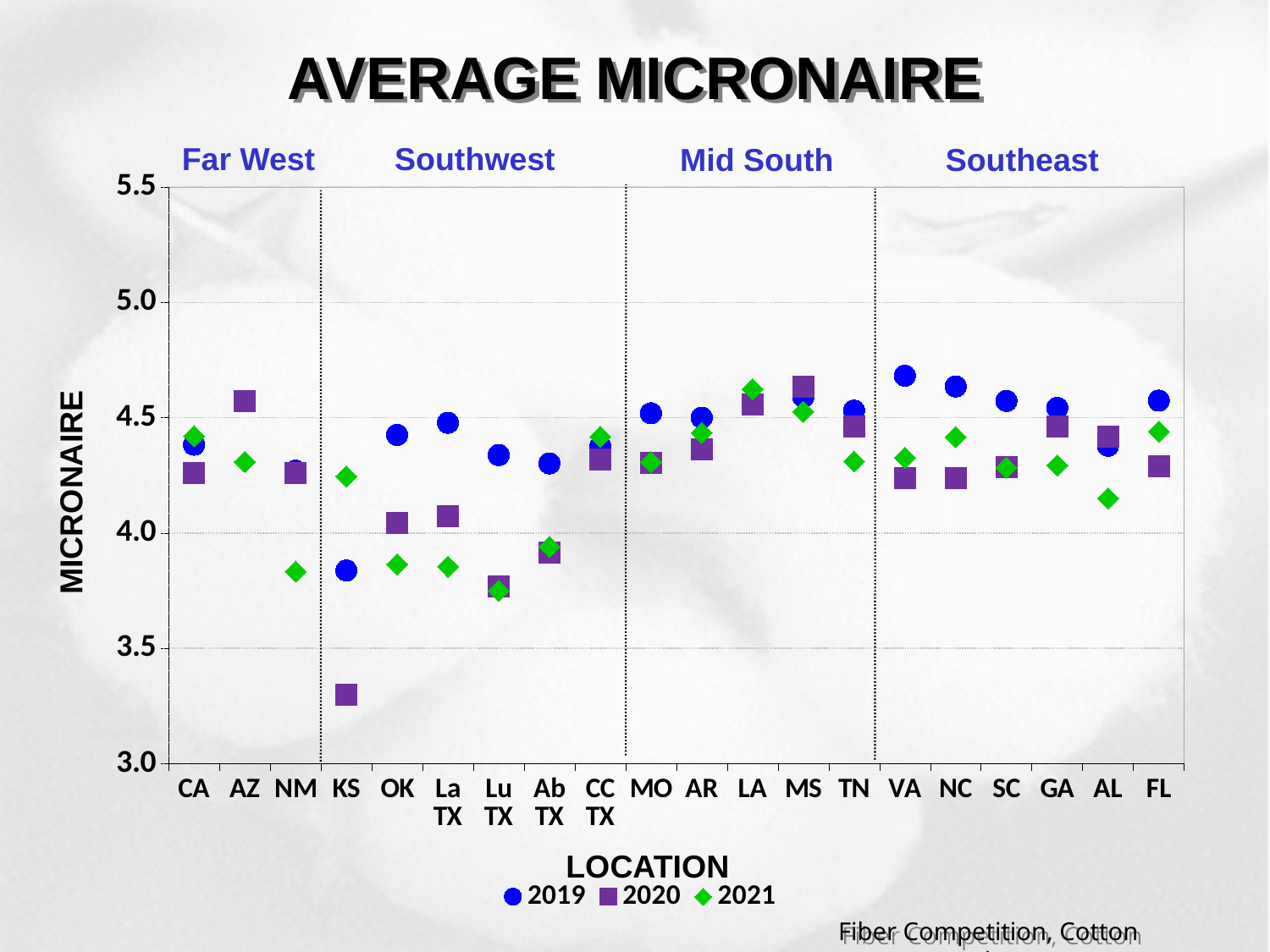
What is the title of the y axis? MICRONAIRE What kind of chart is shown on the slide? Scatter (dot) chart How many series does the legend list? 3 Is the 2019 value for VA greater or less than 4.5? greater Which location has the lowest 2019 micronaire value? KS Is the 2021 value for AL greater or less than 4.5? less Is the 2020 value for KS greater or less than 3.5? less For KS, which is larger, the 2019 value or the 2020 value? 2019 How many locations are plotted along the x axis? 20 Which location has the lowest 2020 micronaire value? KS Which location has the lowest 2021 micronaire value? Lu TX